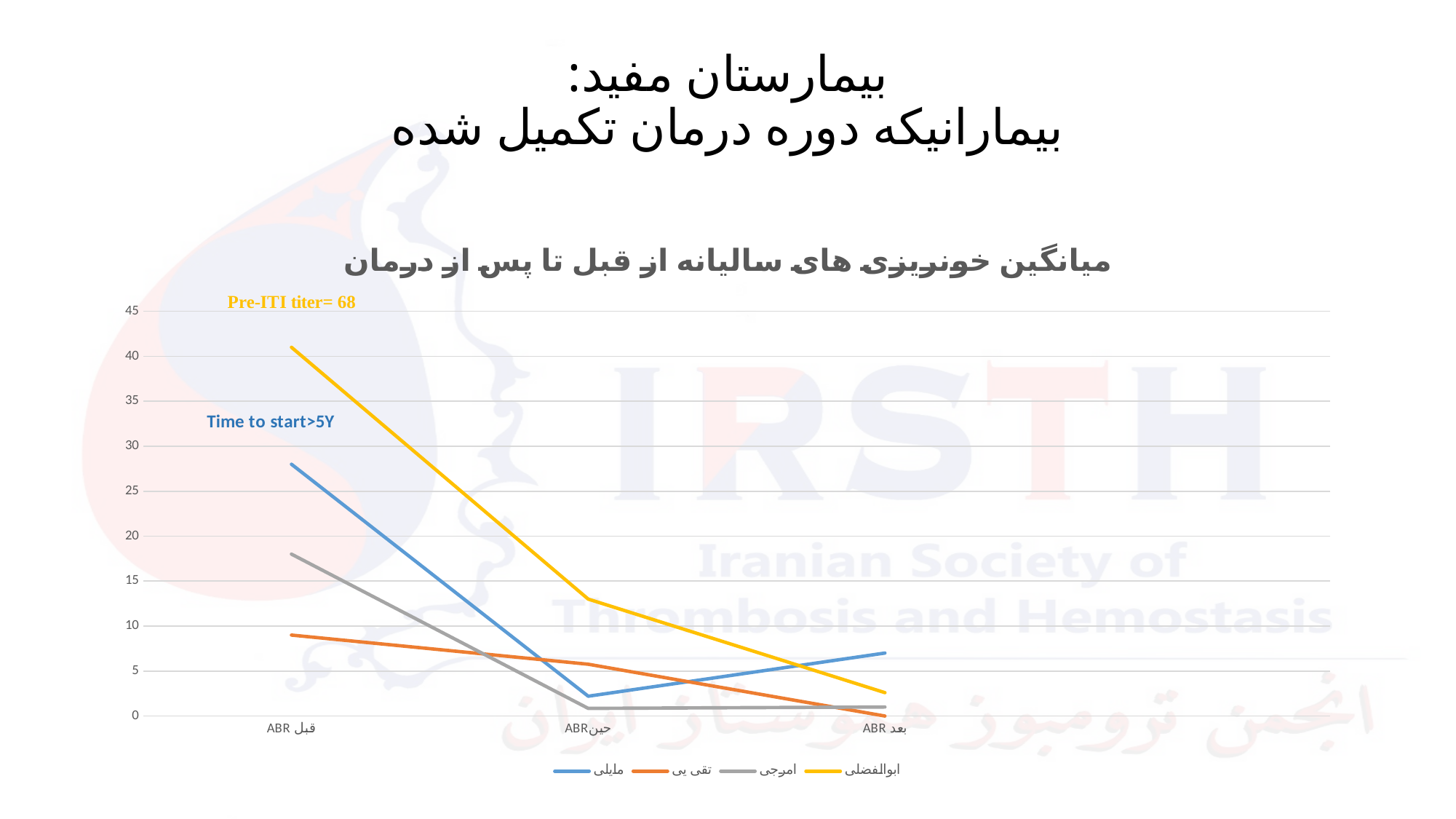
Which series has the lowest value at قبل ABR? تقی یی What Pre-ITI titer value is annotated on the chart? Pre-ITI titer= 68 Is the value for ابوالفضلی at قبل ABR greater or less than 35? greater Does the ابوالفضلی line rise or fall from قبل ABR to بعد ABR? fall Which series has the highest value at قبل ABR? ابوالفضلی At بعد ABR, which is larger: the value for ملیلی or the value for ابوالفضلی? مایلی What kind of chart is shown on the slide? line chart How many categories are on the x axis? 3 How many series does the legend list? 4 Is the value for ابوالفضلی at حین ABR greater or less than 10? greater Is the value for ملیلی at قبل ABR greater or less than 25? greater